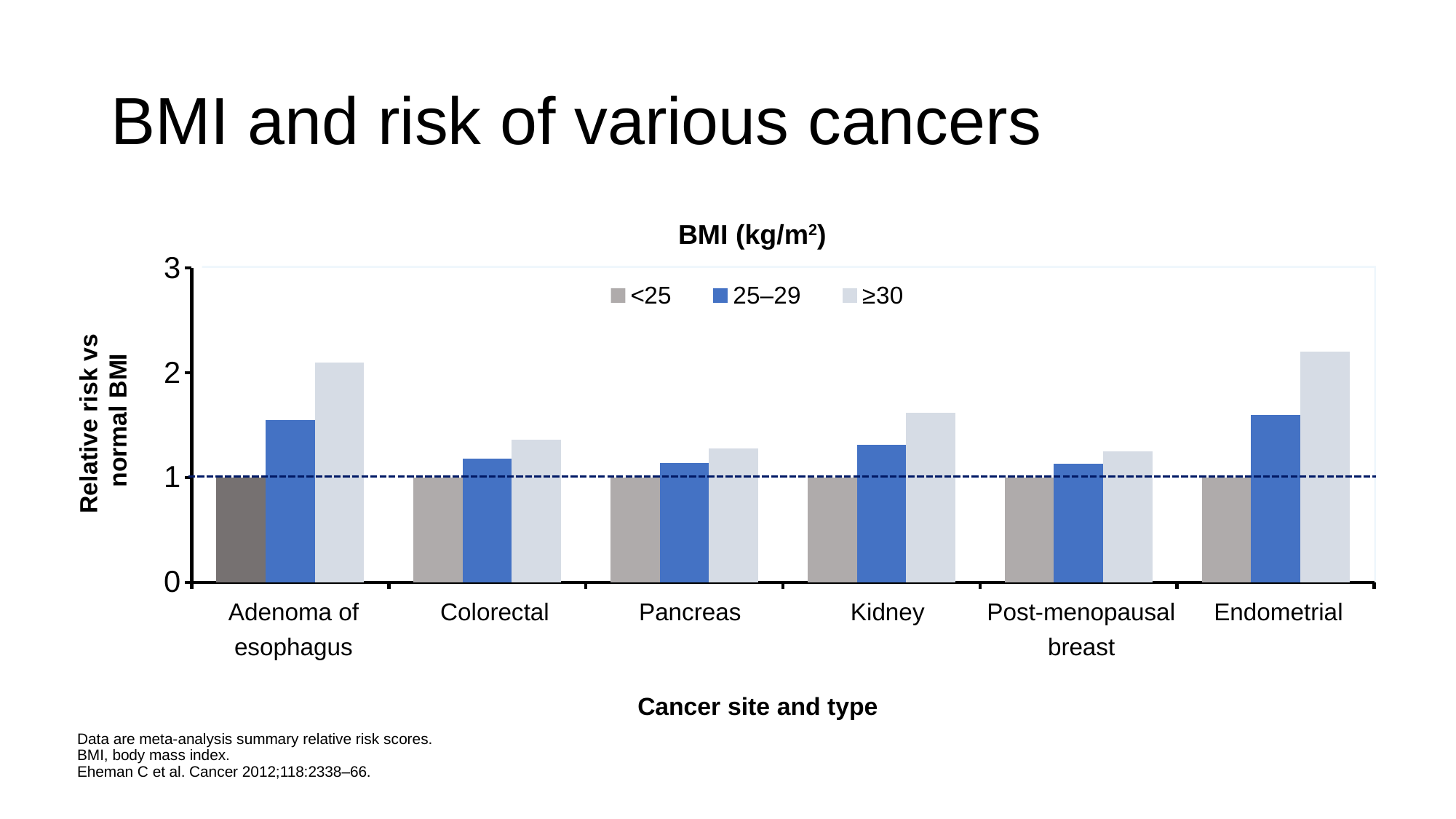
What is the title of the y axis? Relative risk vs normal BMI What is the relative risk for the <25 BMI group for Colorectal cancer? 1 What is the relative risk for the <25 BMI group for Kidney cancer? 1 Which has the larger relative risk for the ≥30 BMI group: Adenoma of esophagus or Colorectal? Adenoma of esophagus Is the relative risk for the ≥30 BMI group for Adenoma of esophagus greater or less than 2? greater Is the relative risk for the ≥30 BMI group for Colorectal cancer greater or less than 2? less What kind of chart is shown on the slide? bar chart How many cancer sites/types are shown on the x axis? 6 How many BMI series does the legend list? 3 Is the relative risk for the 25–29 BMI group for Kidney cancer greater or less than 1? greater Which has the larger relative risk for the 25–29 BMI group: Kidney or Pancreas? Kidney